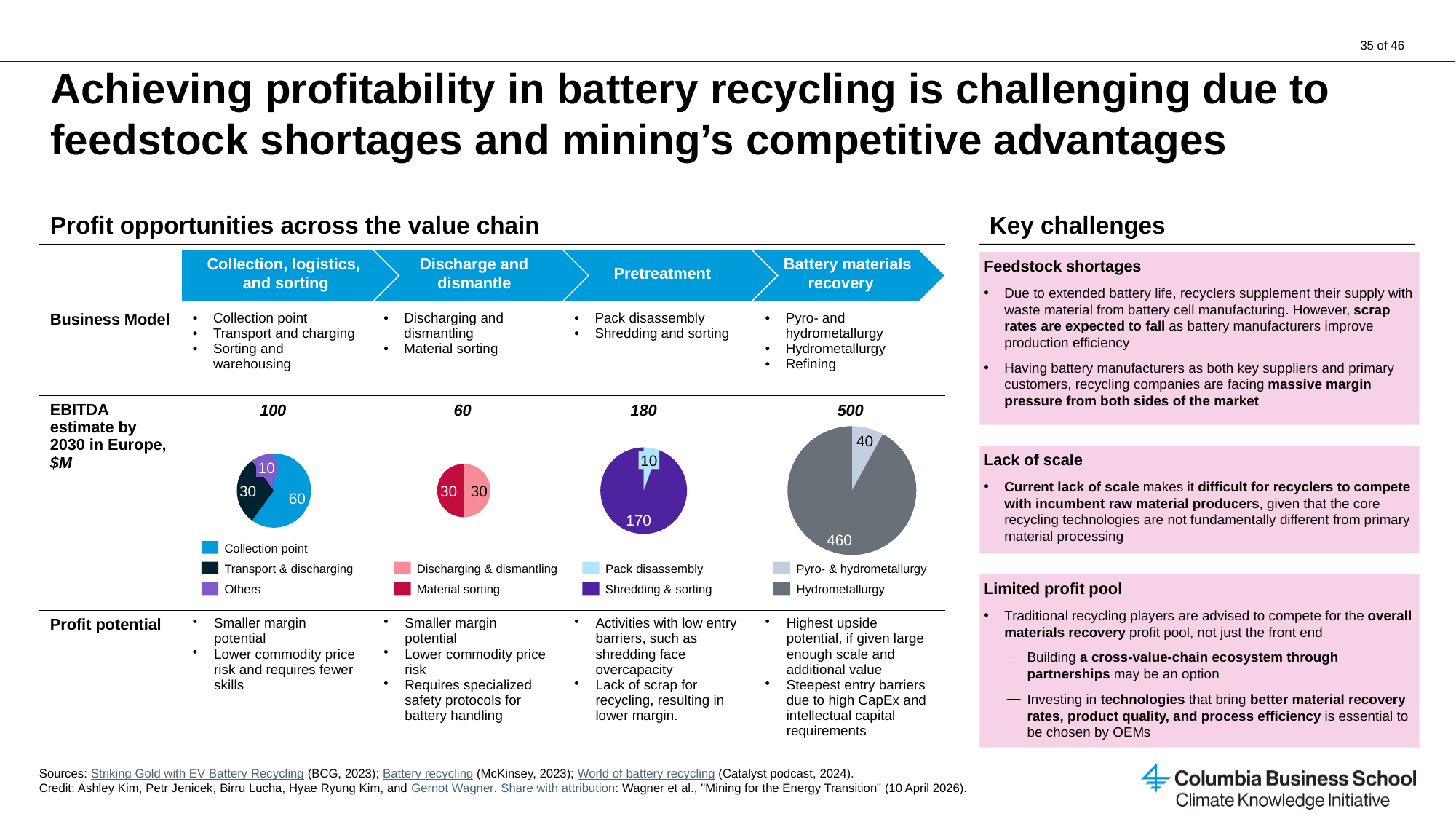
In the Battery materials recovery pie chart, what is the value for Hydrometallurgy? 460 What type of chart is used to show the EBITDA estimates for each value chain stage? Pie chart In the Collection, logistics, and sorting pie chart, which segment is the smallest? Others In the Collection, logistics, and sorting pie chart, what is the difference between Collection point and Transport & discharging? 30 What is the total EBITDA estimate shown above the Discharge and dismantle pie chart? 60 In the Collection, logistics, and sorting pie chart, what is the EBITDA estimate for Collection point? 60 What is the total EBITDA estimate shown above the Battery materials recovery pie chart? 500 In the Discharge and dismantle pie chart, what share of the total does Material sorting represent? 50% In the Pretreatment pie chart, which segment is larger, Pack disassembly or Shredding & sorting? Shredding & sorting In the Battery materials recovery pie chart, what is the difference between Hydrometallurgy and Pyro- & hydrometallurgy? 420 How many segments does the Collection, logistics, and sorting pie chart have? 3 In the Pretreatment pie chart, what is the value for Shredding & sorting? 170